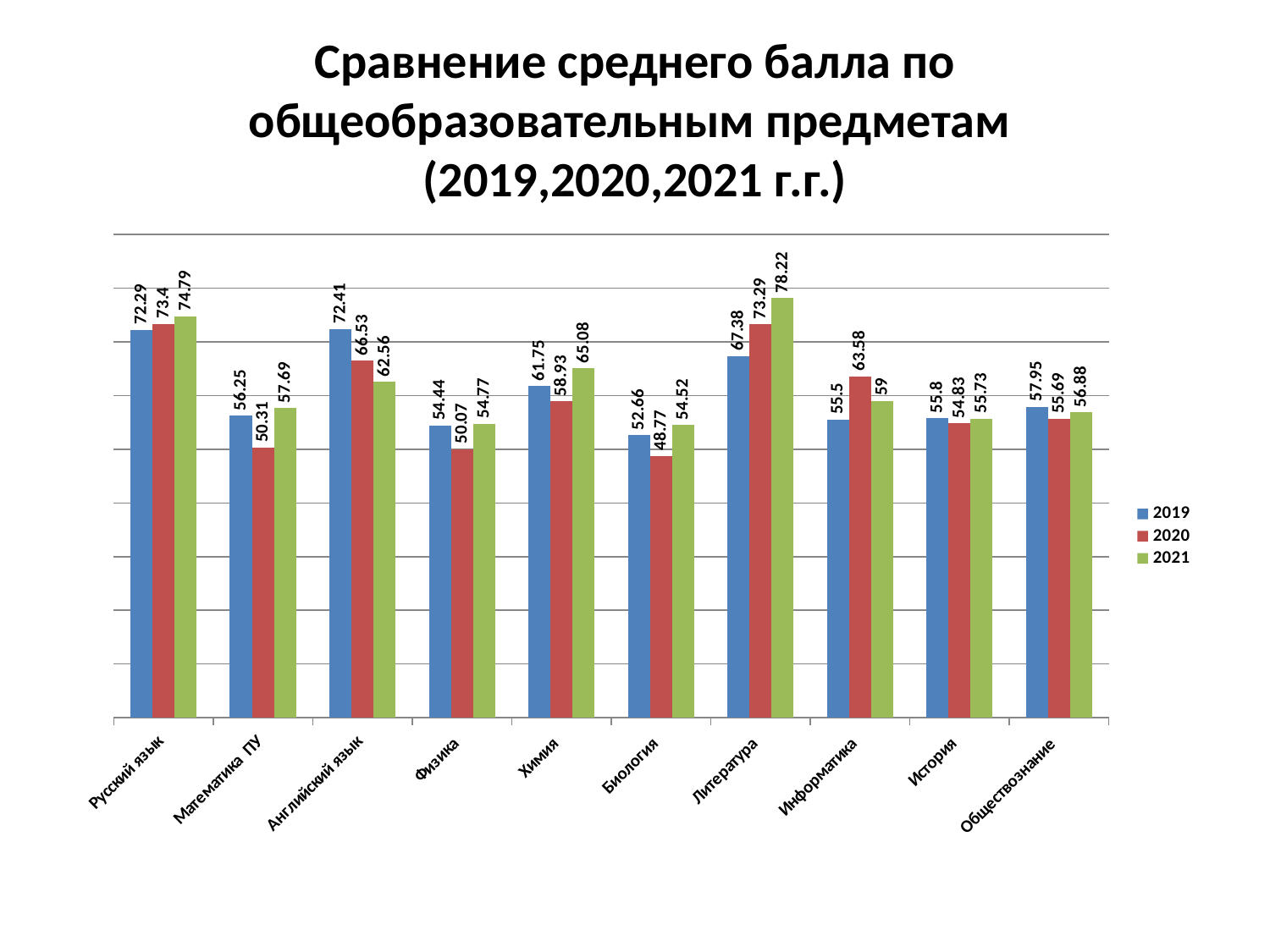
Do the values for Литература rise or fall from 2019 to 2021? Rise Which subject has the highest value in the 2021 series? Литература How many subjects are shown on the x axis? 10 What is the difference between the 2019 and 2021 values for Английский язык? 9.85 Which subject has the lowest value in the 2020 series? Биология What is the difference between the 2021 and 2019 values for Литература? 10.84 What kind of chart is shown on the slide? Bar chart What is the value for Биология in 2019? 52.66 What is the value for Русский язык in 2021? 74.79 How many series does the legend list? 3 What is the value for Информатика in 2020? 63.58 Which is larger for Математика ПУ: the 2019 value or the 2020 value? 2019